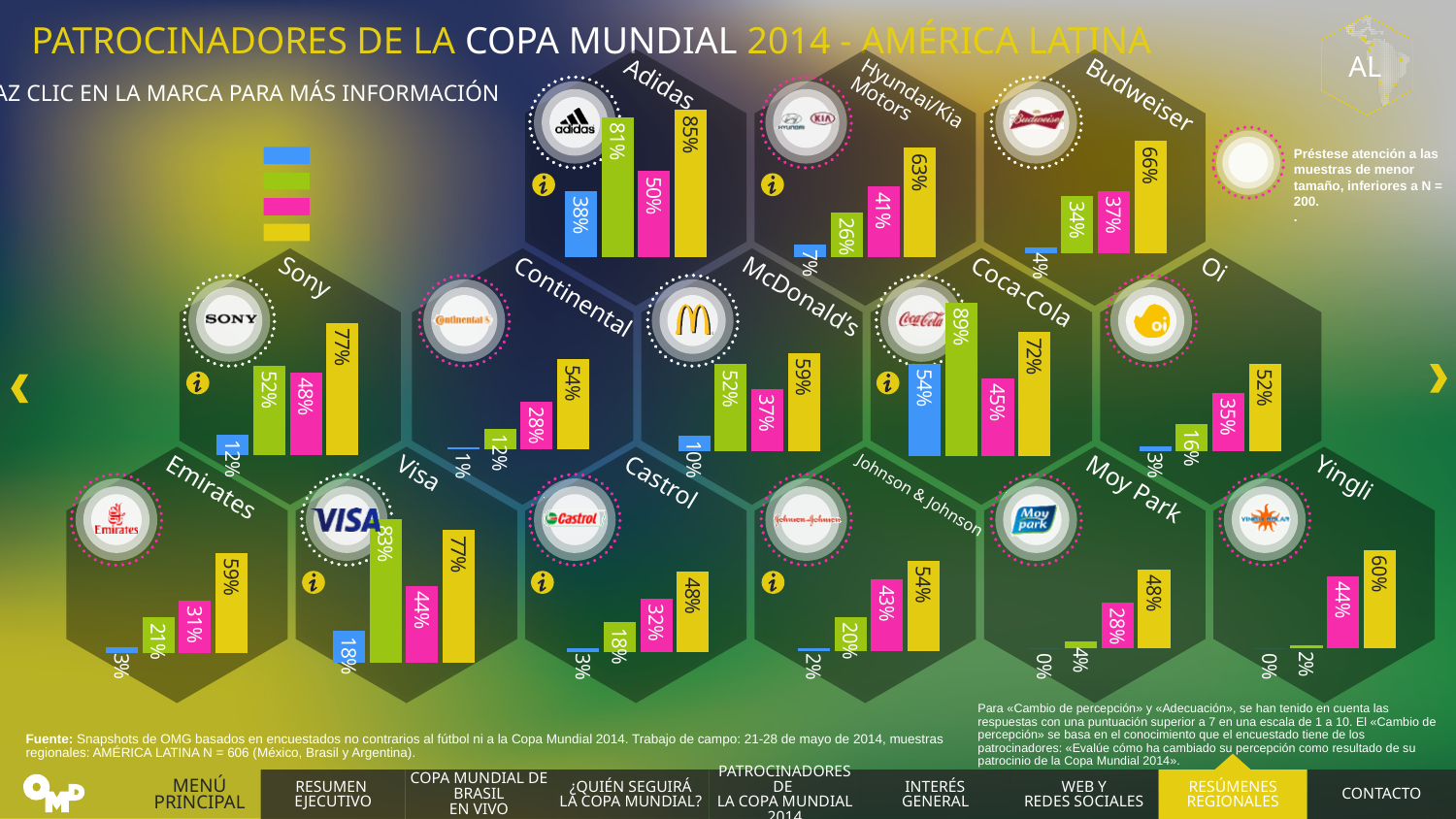
In the Adidas chart, what is the value of the yellow bar? 85% In the Budweiser chart, which is larger, the green bar or the pink bar? pink bar In the Coca-Cola chart, what is the value of the green bar? 89% How many sponsor charts are shown on the slide? 14 What type of chart is used for each sponsor on the slide? bar chart In the Continental chart, which coloured bar is the lowest? blue In the Sony chart, what is the difference between the yellow bar and the green bar? 25% In the Hyundai/Kia Motors chart, which coloured bar is the highest? yellow In the Moy Park chart, what is the value of the pink bar? 28% In the Yingli chart, what is the total of the four bars? 106% How many colours does the legend at the top left show? 4 In the Visa chart, what is the value of the blue bar? 18%